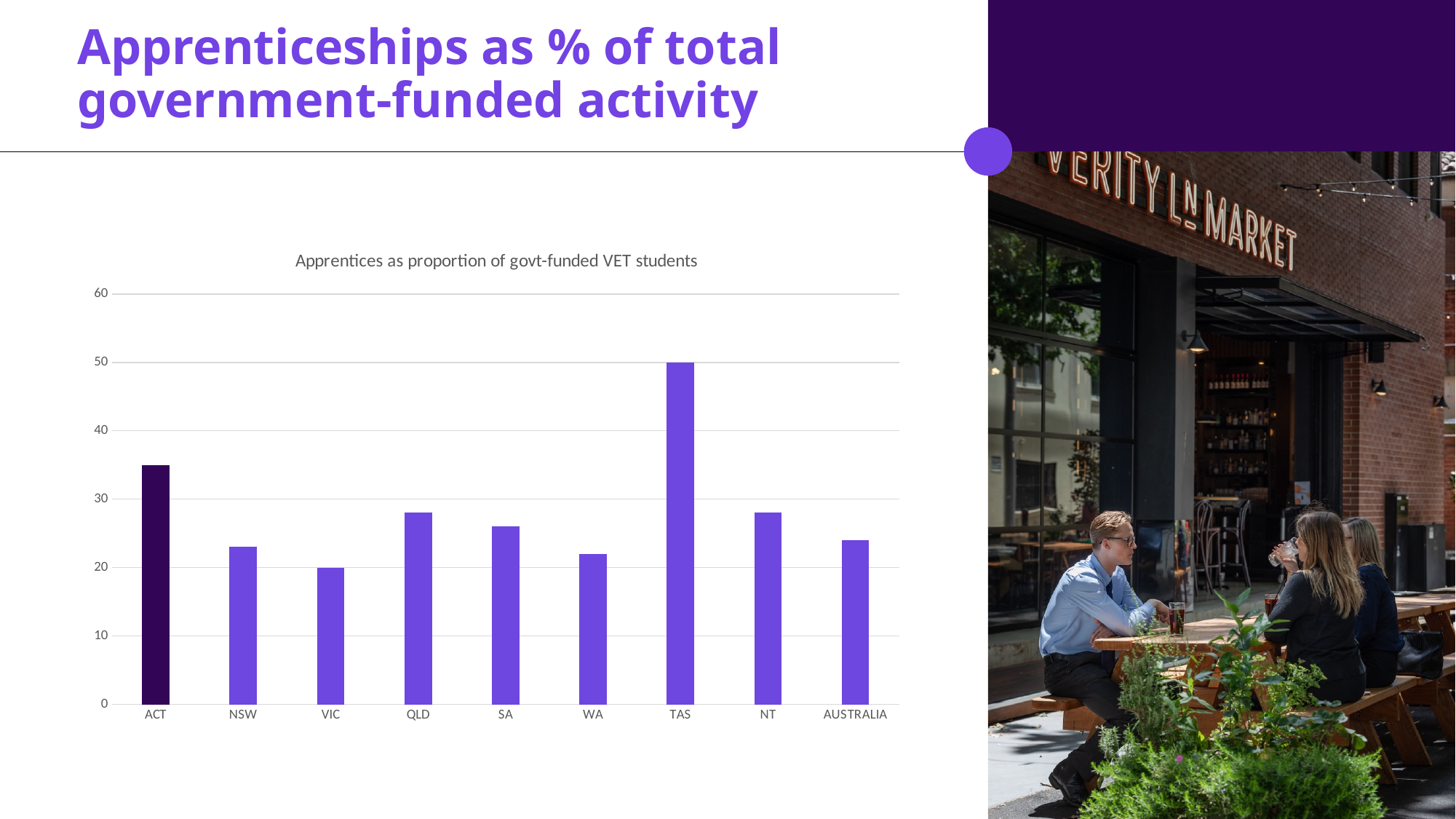
Which is larger, the value for ACT or the value for NSW? ACT What is the value for VIC? 20 What is the value for TAS? 50 What is the title of the chart? Apprentices as proportion of govt-funded VET students Which category has the lowest value in the chart? VIC How many categories are shown on the x axis of the chart? 9 Is the value for ACT greater or less than 30? greater Which category has the highest value in the chart? TAS Is the value for NSW greater or less than 30? less Which bar is shown in a darker colour than the others? ACT Is the value for WA greater or less than 20? greater What type of chart is shown on the slide? bar chart